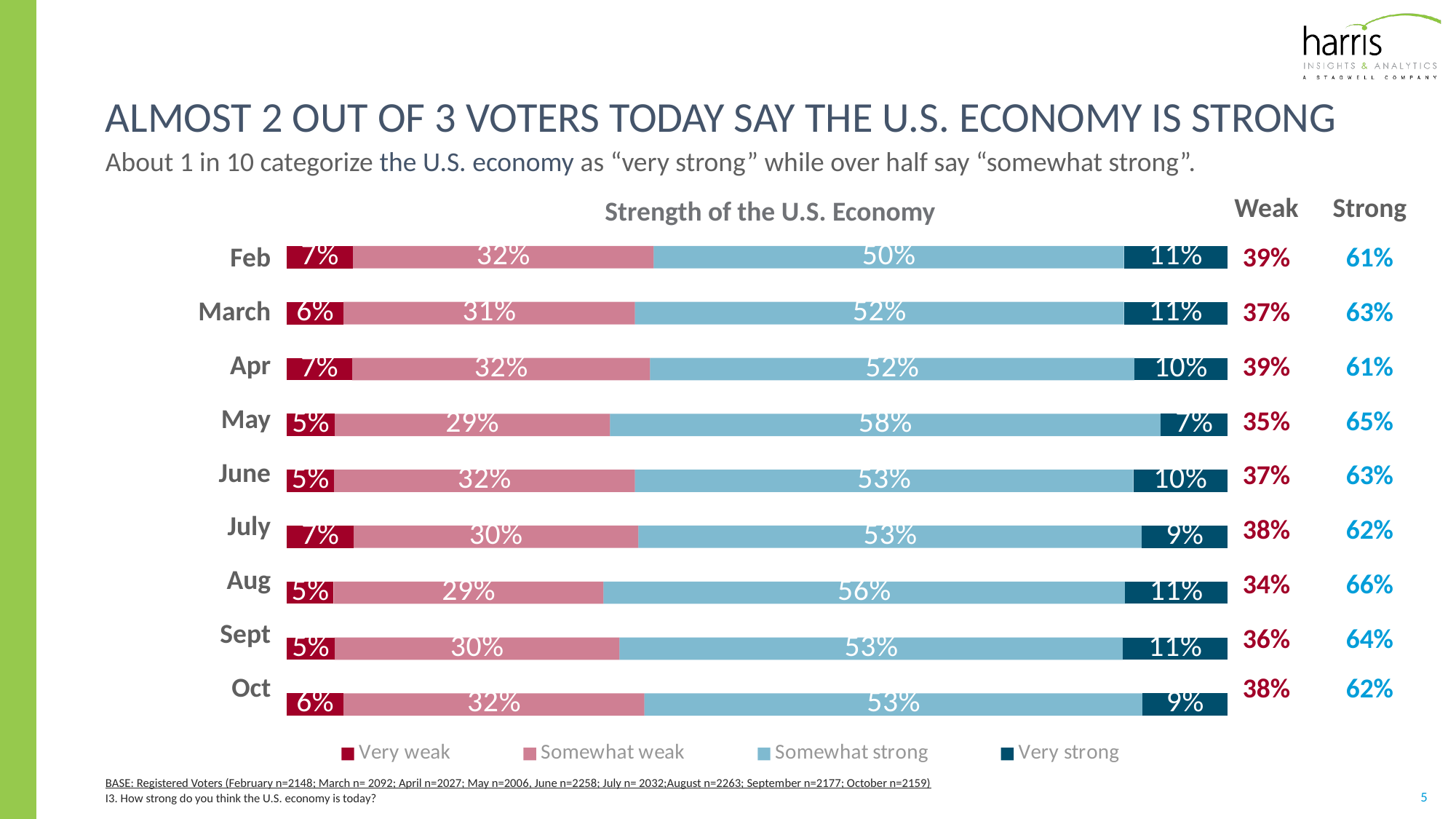
What is the "Very strong" value for Oct? 9% Which month has the larger "Somewhat strong" value, Aug or Oct? Aug How many months are shown in the chart? 9 What is the title of the chart? Strength of the U.S. Economy What is the difference between the "Somewhat strong" value in May and in Feb? 8 percentage points In which month is the "Somewhat strong" share the highest? May What is the "Very weak" value for Feb? 7% How many series does the legend list? 4 In which month is the "Very strong" share the lowest? May What kind of chart is shown on the slide? Stacked bar chart What is the total of the stacked bar for Feb? 100% What percentage of voters said the U.S. economy was "Somewhat strong" in May? 58%